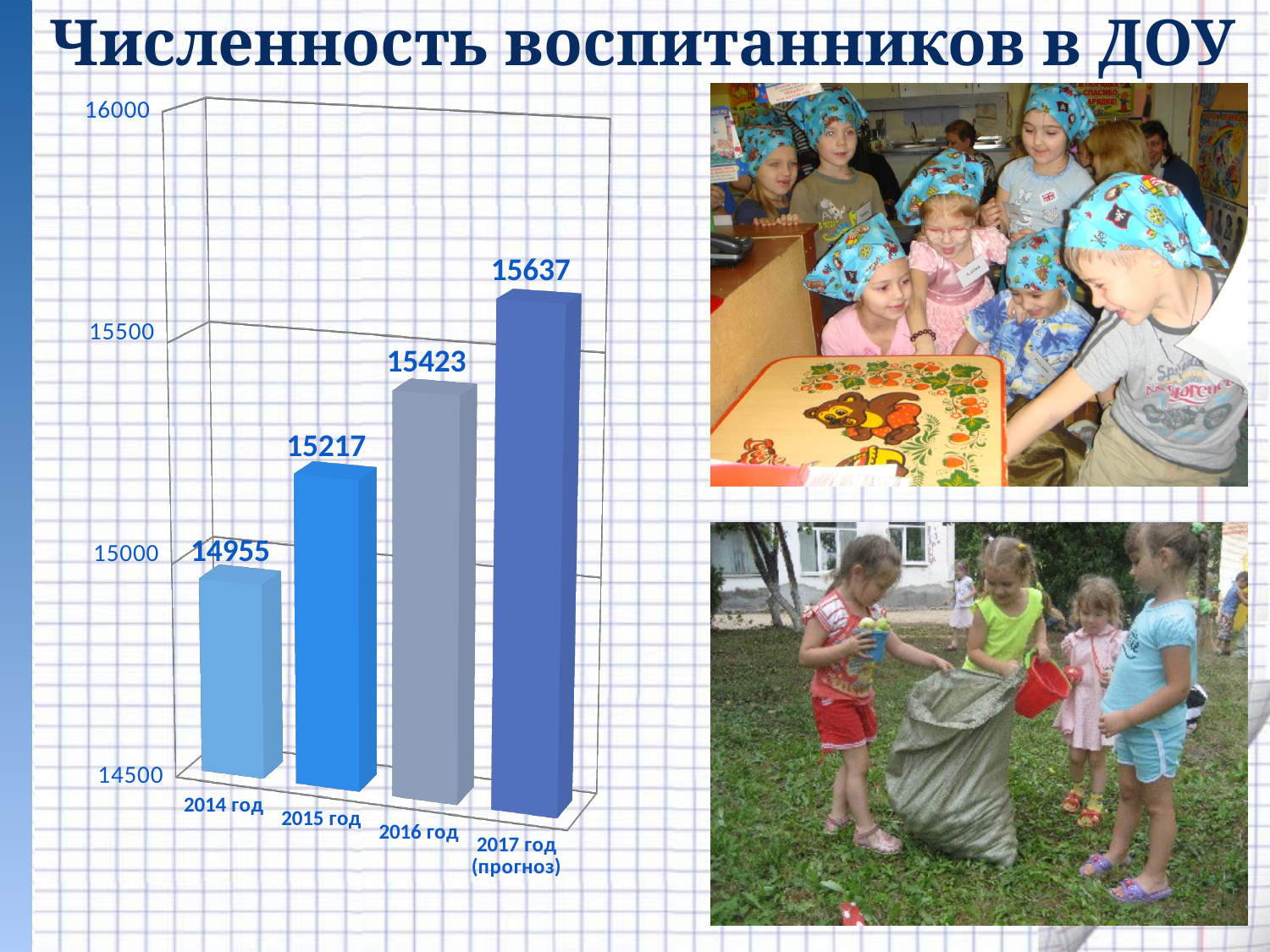
What is the difference between the values for 2017 год (прогноз) and 2014 год? 682 Is the value for 2014 год greater or less than 15000? less What is the value for 2014 год? 14955 What is the value for 2015 год? 15217 What kind of chart is shown on the slide? bar chart What is the value for 2016 год? 15423 What is the difference between the values for 2016 год and 2015 год? 206 Which year has the highest value? 2017 год (прогноз) Which is larger, the value for 2015 год or the value for 2016 год? 2016 год Which year has the lowest value? 2014 год What is the forecast value for 2017 год (прогноз)? 15637 How many years are shown on the chart? 4